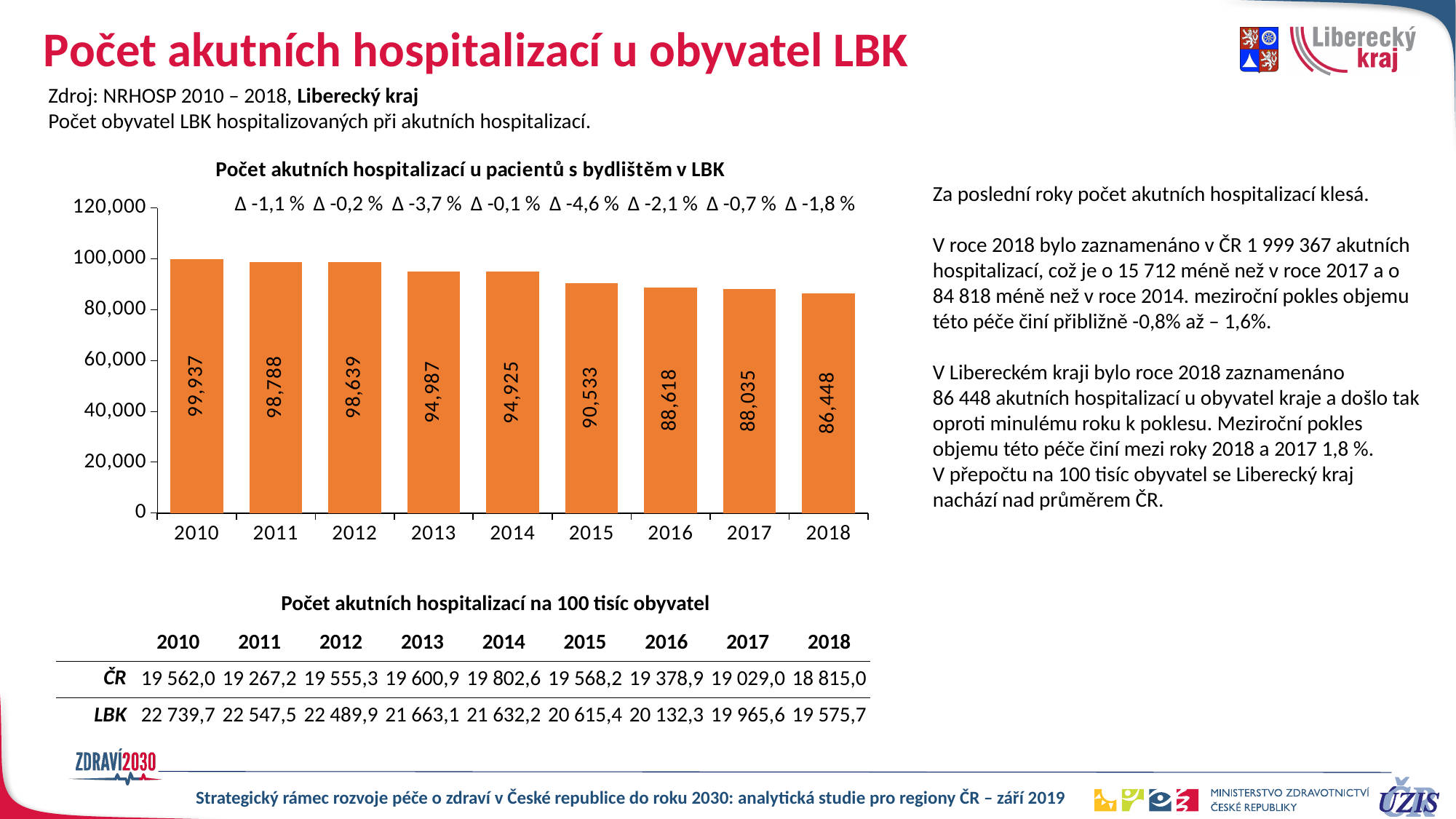
What is the value for 2015 in the bar chart? 90,533 Which year has the highest value in the bar chart? 2010 What kind of chart is shown on the slide? bar chart Is the value for 2015 in the bar chart greater or less than 80,000? greater What is the difference between the values for 2017 and 2018 in the bar chart? 1,587 What is the difference between the values for 2010 and 2018 in the bar chart? 13,489 Which is larger in the bar chart, the value for 2011 or the value for 2016? 2011 How many years are shown on the x axis of the bar chart? 9 What is the value for 2010 in the bar chart? 99,937 Which year has the lowest value in the bar chart? 2018 Do the values in the bar chart rise or fall from 2010 to 2018? fall What is the value for 2018 in the bar chart? 86,448